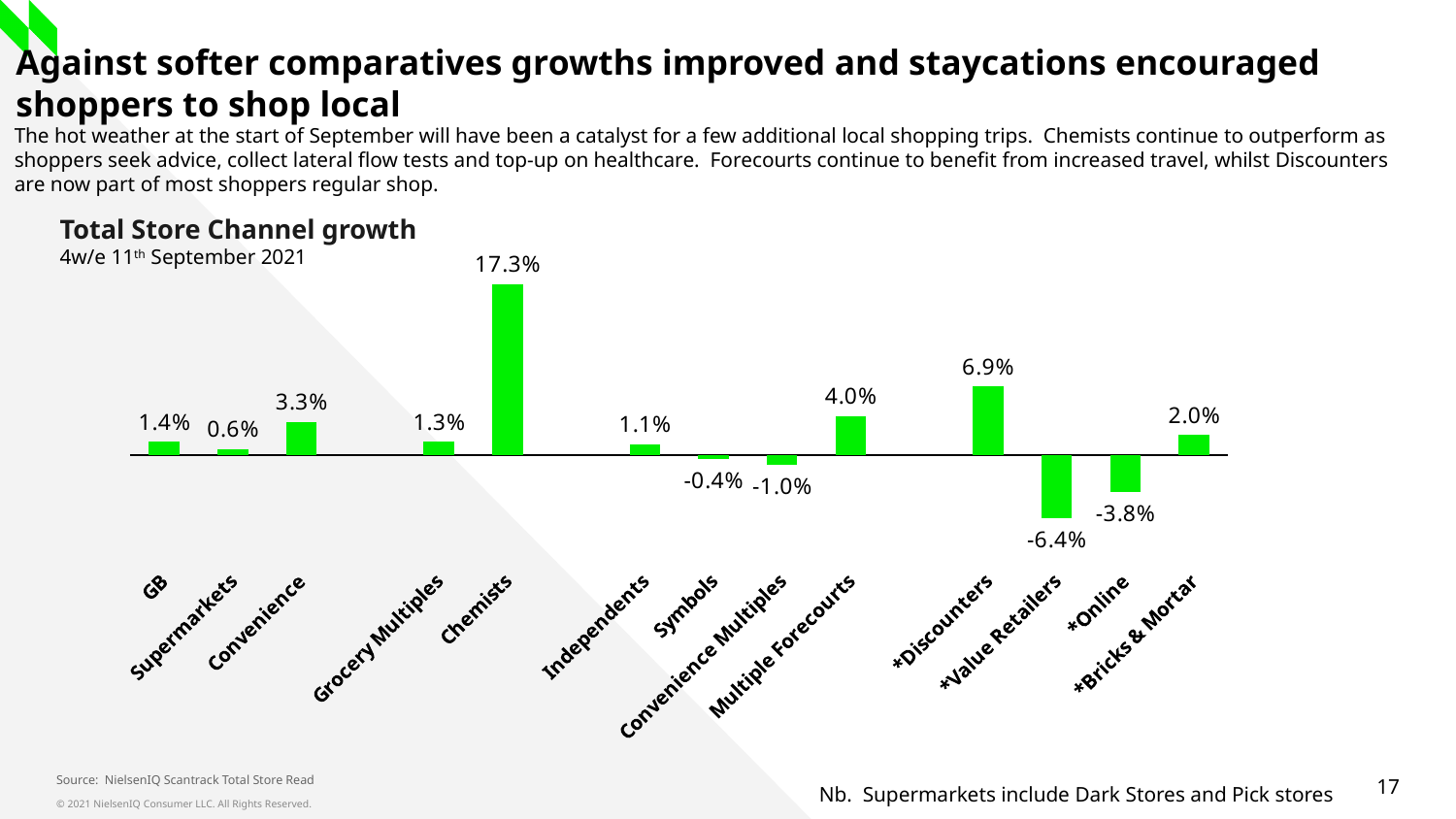
How many channel categories are plotted in the chart? 13 What is the growth value for Chemists in the Total Store Channel growth chart? 17.3% How many channels show negative growth in the chart? 4 What is the growth value shown for *Value Retailers? -6.4% What is the difference in growth between Convenience and Supermarkets? 2.7 percentage points What is the growth value shown for Supermarkets? 0.6% Which channel has the lowest growth in the chart? *Value Retailers What is the growth value shown for Multiple Forecourts? 4.0% What is the difference in growth between Chemists and *Discounters? 10.4 percentage points Which channel has the highest growth in the chart? Chemists What type of chart is used to show Total Store Channel growth? Bar chart Which has the higher growth, *Discounters or Multiple Forecourts? *Discounters